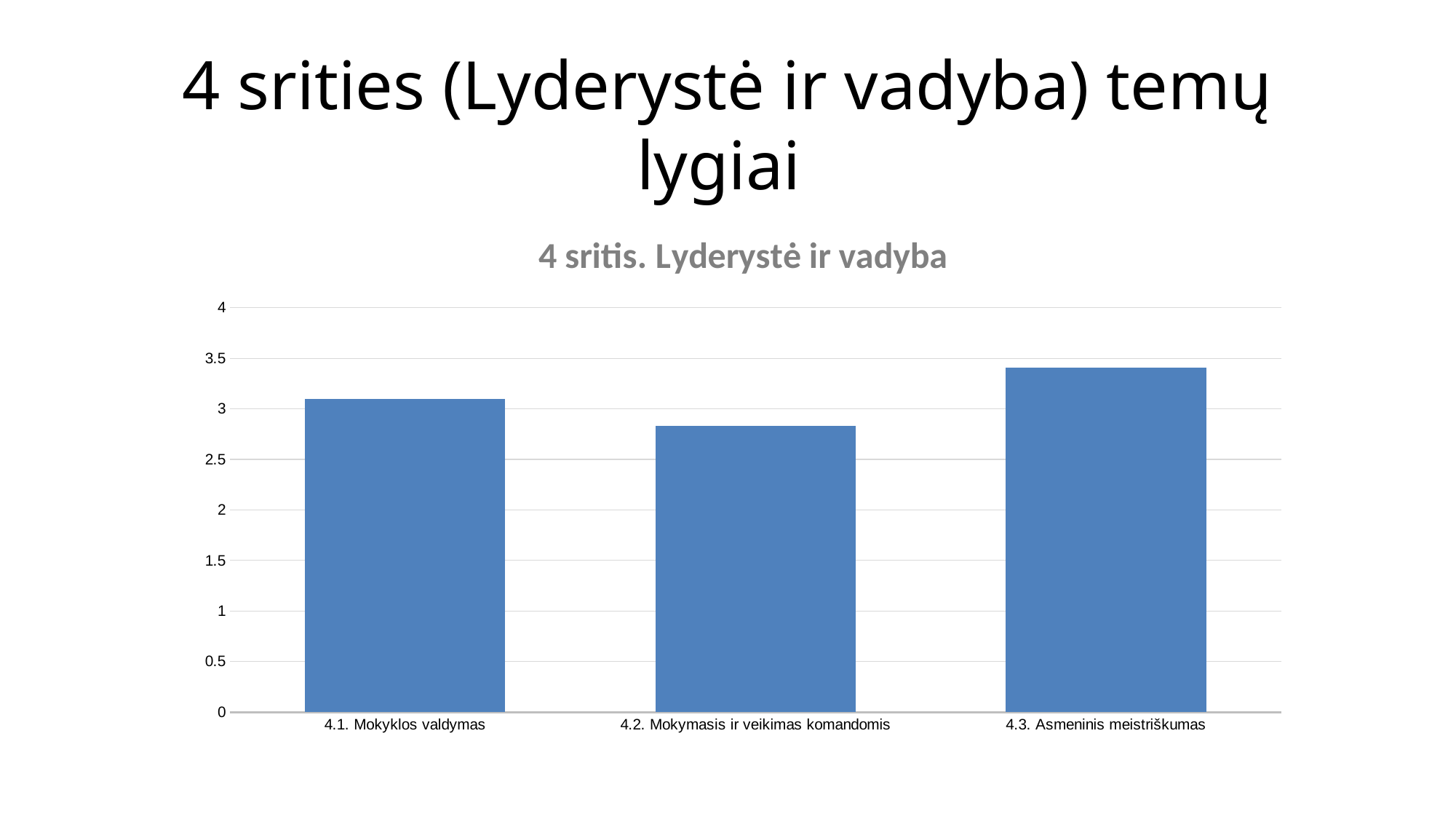
Which category has the highest value? 4.3. Asmeninis meistriškumas Is the value for 4.1. Mokyklos valdymas greater or less than 3? greater Which is larger, the value for 4.3. Asmeninis meistriškumas or the value for 4.1. Mokyklos valdymas? 4.3. Asmeninis meistriškumas Is the value for 4.2. Mokymasis ir veikimas komandomis greater or less than 2.5? greater Is the value for 4.3. Asmeninis meistriškumas greater or less than 3.5? less What is the maximum value shown on the vertical axis? 4 How many categories are plotted in the chart? 3 What kind of chart is shown on the slide? bar chart Which is larger, the value for 4.1. Mokyklos valdymas or the value for 4.2. Mokymasis ir veikimas komandomis? 4.1. Mokyklos valdymas Which category has the lowest value? 4.2. Mokymasis ir veikimas komandomis What is the title of the chart? 4 sritis. Lyderystė ir vadyba